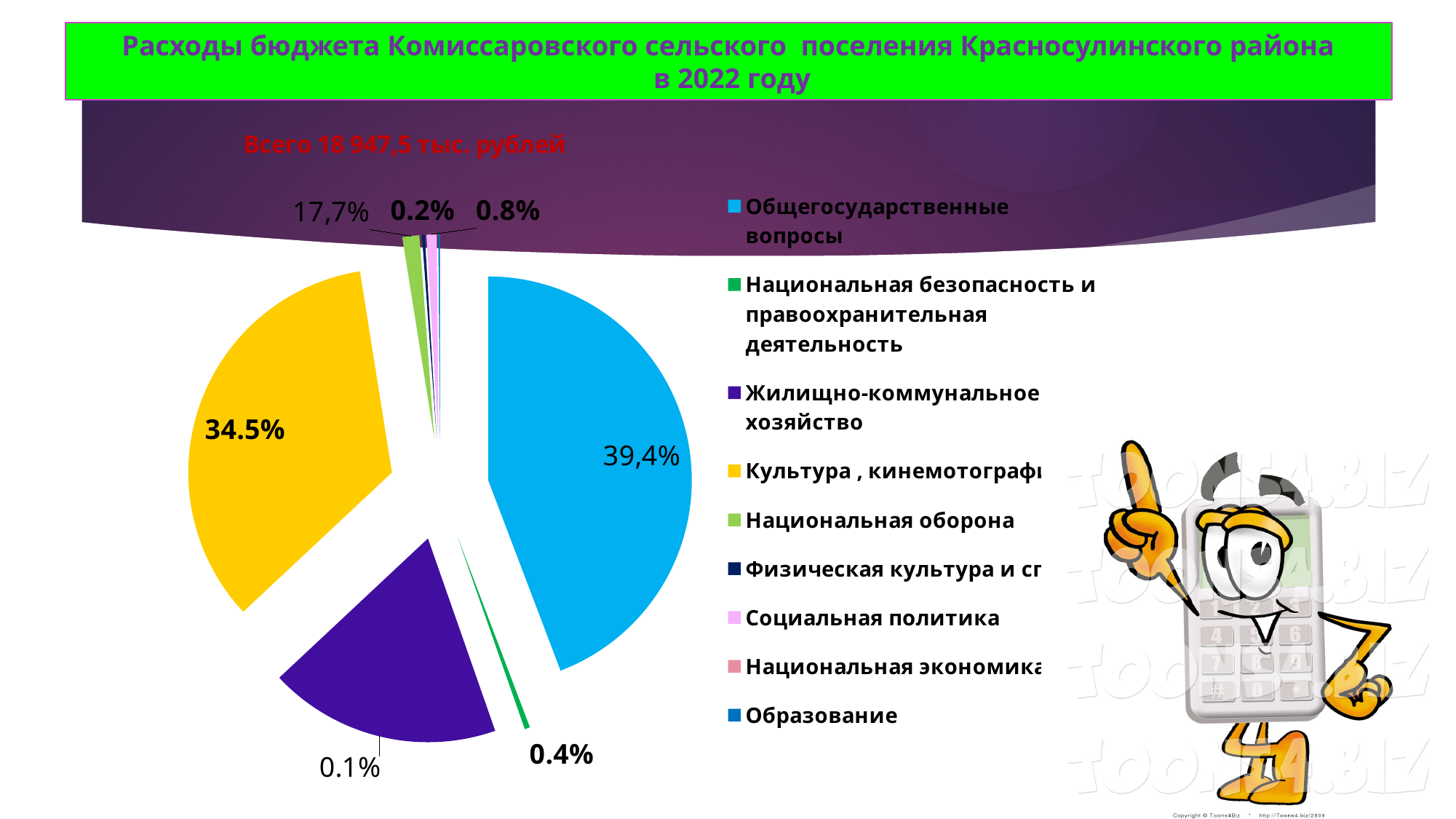
How many categories does the legend list? 9 Which category has the largest slice of the pie? Общегосударственные вопросы Is the share for Общегосударственные вопросы greater or less than 30%? greater What total amount is stated above the pie chart? Всего 18 947,5 тыс. рублей What colour is the slice for Культура, кинемотография? yellow What kind of chart is shown on the slide? pie chart What share of the pie is labelled for Общегосударственные вопросы (the blue slice)? 39,4% What year does the chart title say the budget expenditures are for? 2022 What share of the pie is labelled for Культура, кинемотография (the yellow slice)? 34.5% What is the smallest percentage label printed on the pie chart? 0.1% Which slice is larger: Общегосударственные вопросы or Культура, кинемотография? Общегосударственные вопросы